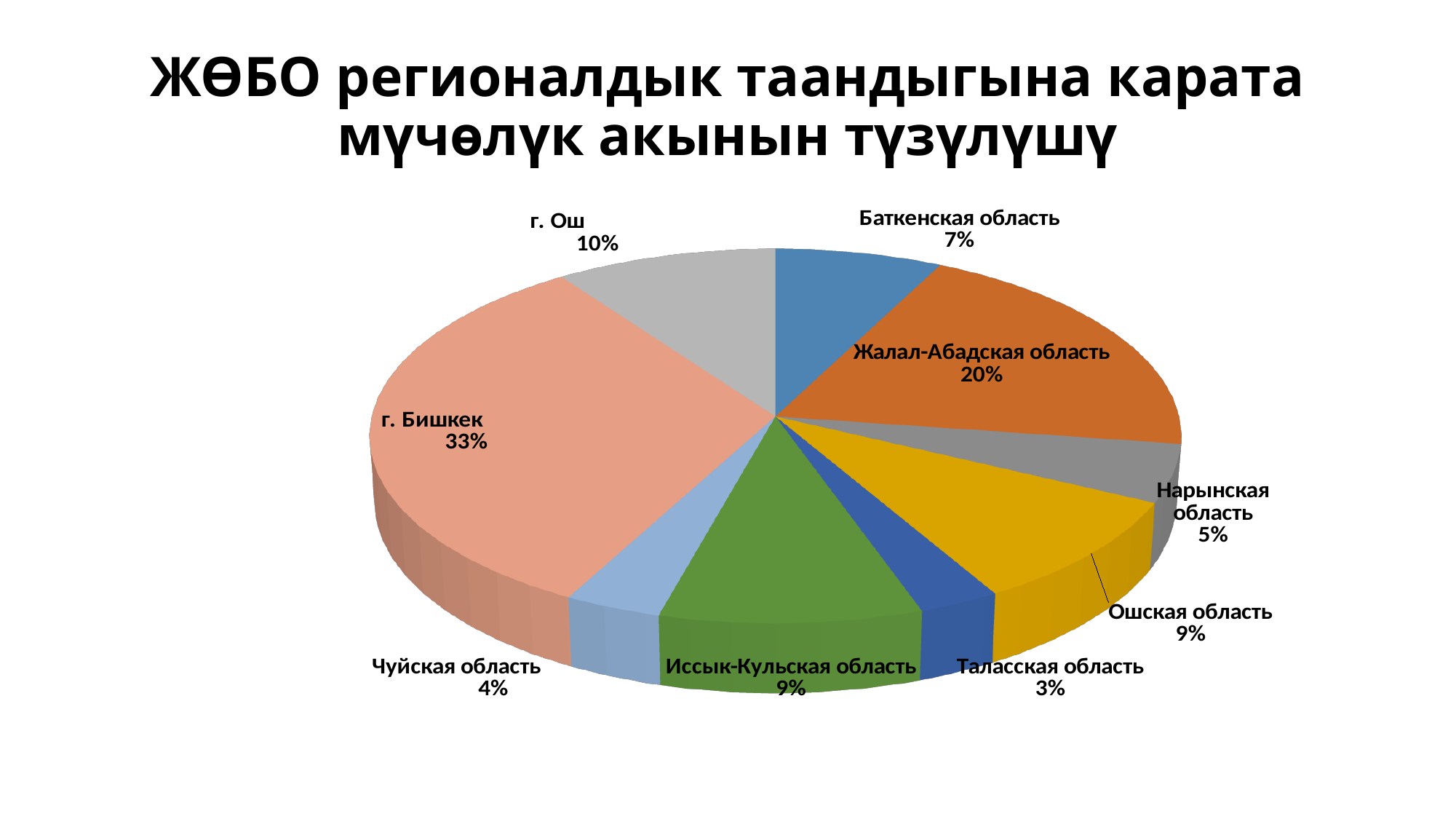
What is the difference between the shares of г. Бишкек and Жалал-Абадская область? 13% What share of the pie does г. Бишкек have? 33% Which category has the largest slice of the pie? г. Бишкек What is the value shown for Жалал-Абадская область? 20% What is the combined share of Иссык-Кульская область and Ошская область? 18% What is the value shown for Таласская область? 3% What is the title of the chart on the slide? ЖӨБО регионалдык таандыгына карата мүчөлүк акынын түзүлүшү How many categories (slices) does the pie chart have? 9 Which category has the smallest slice of the pie? Таласская область What kind of chart is shown on the slide? pie chart Which is larger, the share for г. Ош or the share for Баткенская область? г. Ош What is the value shown for Нарынская область? 5%